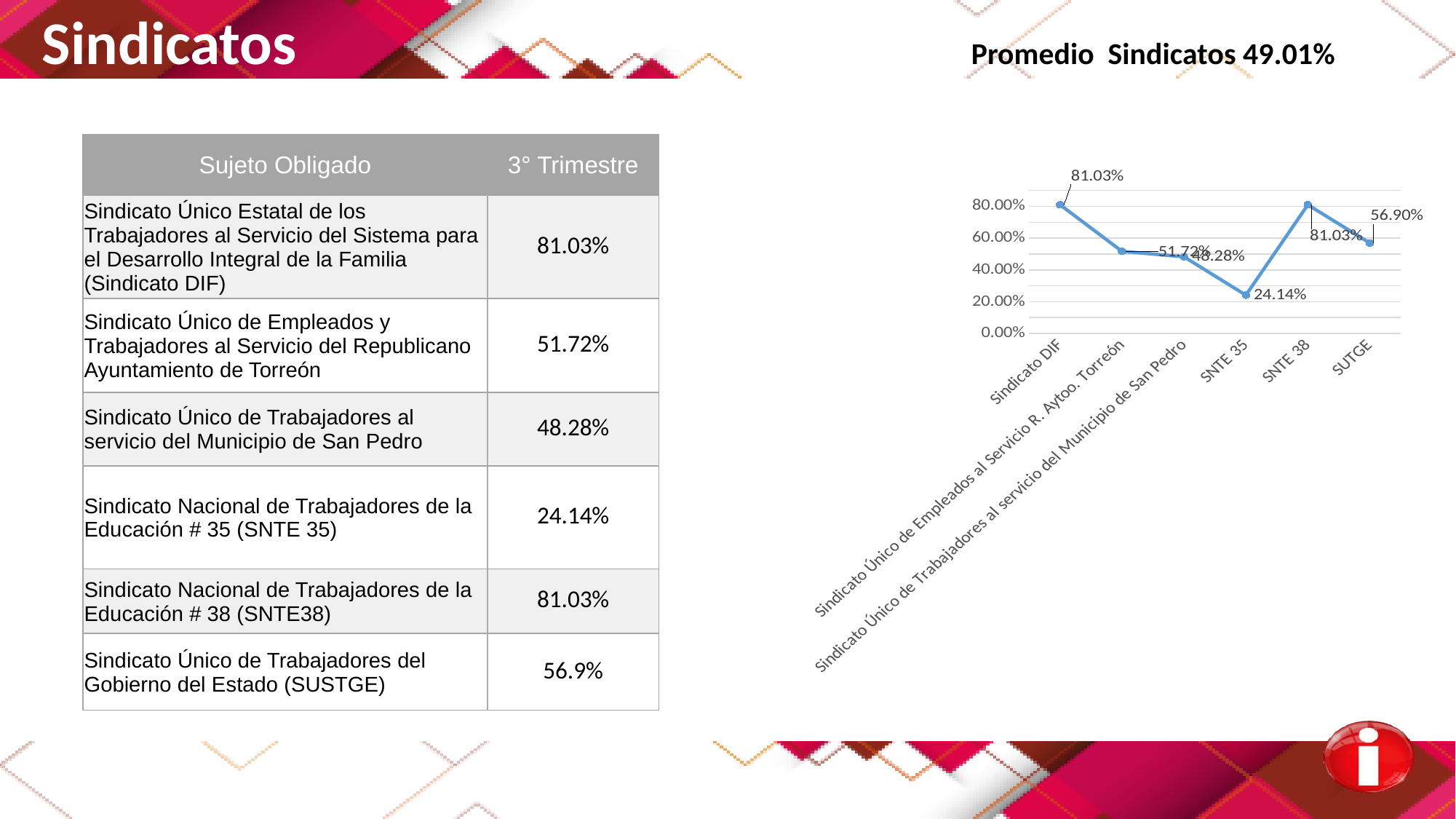
Does the line rise or fall between SNTE 38 and SUTGE in the chart? fall What is the value for Sindicato Único de Trabajadores al servicio del Municipio de San Pedro in the chart? 48.28% Is the value for Sindicato Único de Empleados al Servicio R. Aytoo. Torreón greater or less than 40.00%? greater How many categories are plotted on the x axis of the chart? 6 What is the value for SUTGE in the chart? 56.90% What is the value for Sindicato DIF in the chart? 81.03% What is the value for SNTE 38 in the chart? 81.03% What type of chart is shown on the slide? line chart What is the difference between the values for SNTE 38 and SNTE 35 in the chart? 56.89% Which category has the lowest value in the chart? SNTE 35 What is the value for SNTE 35 in the chart? 24.14% Which is larger in the chart, the value for SUTGE or the value for SNTE 35? SUTGE